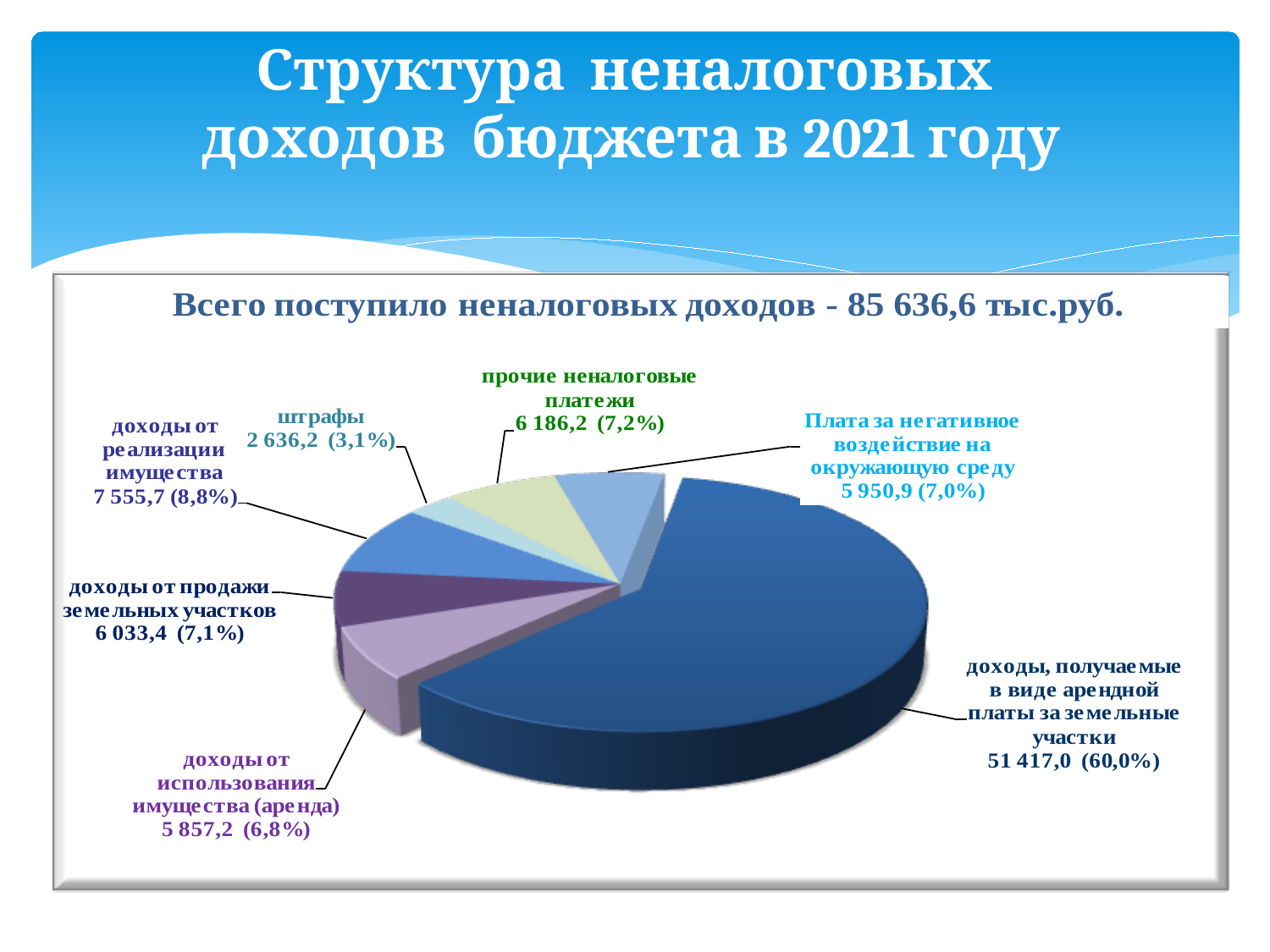
What total amount of non-tax revenue is stated above the chart? 85 636,6 тыс.руб. What kind of chart is shown on the slide? Pie chart Which category has the smallest share of the pie? штрафы What is the difference between the values for «доходы от реализации имущества» and «доходы от продажи земельных участков»? 1 522,3 How many slices does the pie chart have? 7 Which is larger: the value for «доходы от продажи земельных участков» or for «доходы от использования имущества (аренда)»? доходы от продажи земельных участков What share of the pie does «доходы от использования имущества (аренда)» represent? 6,8% What is the value for «штрафы»? 2 636,2 What share of the pie does «доходы от реализации имущества» represent? 8,8% What is the value for «доходы, получаемые в виде арендной платы за земельные участки»? 51 417,0 What is the value for «Плата за негативное воздействие на окружающую среду»? 5 950,9 Which category has the largest share of the pie? доходы, получаемые в виде арендной платы за земельные участки